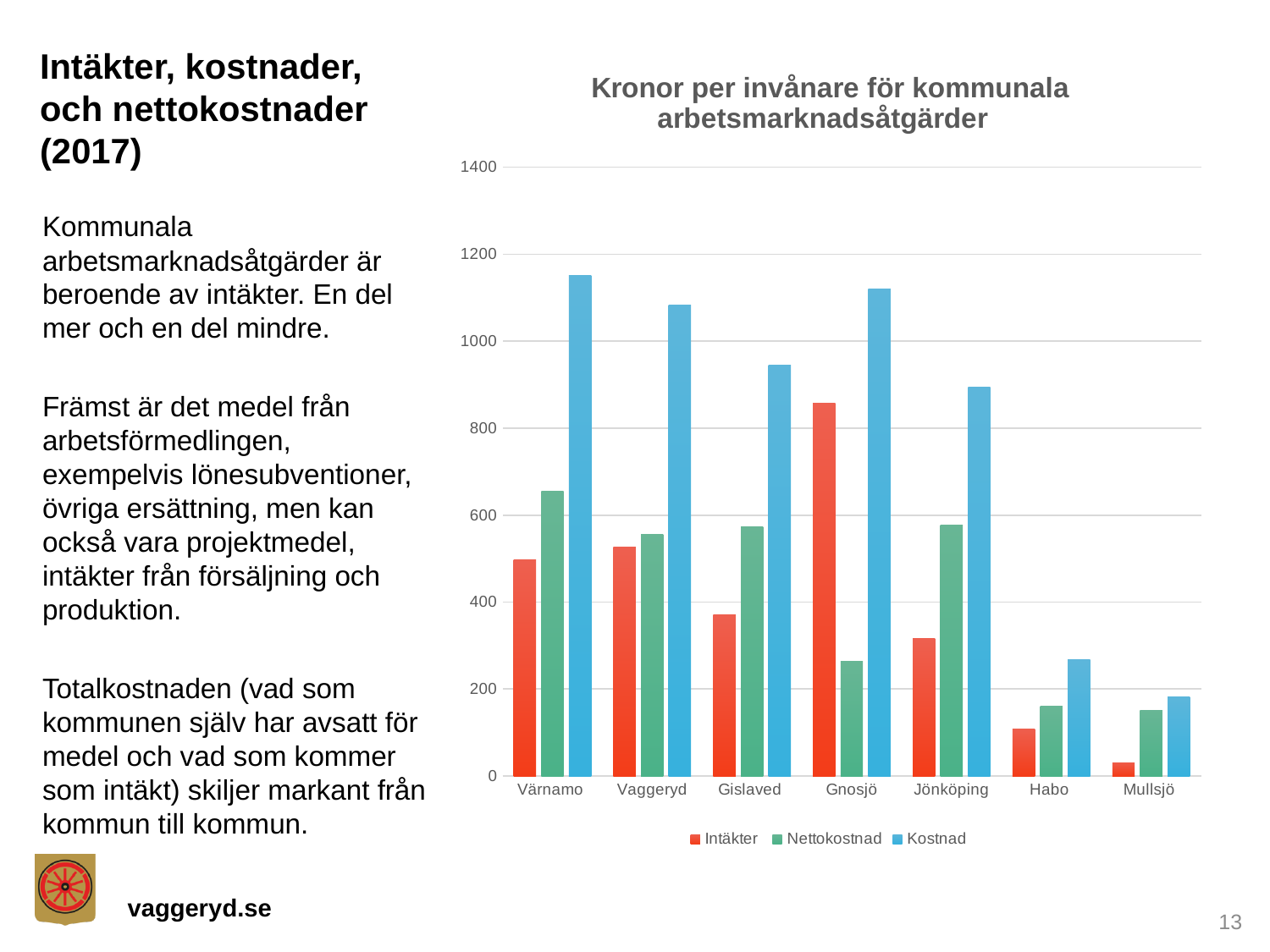
Is the Kostnad value for Gislaved greater or less than 1000? less Which municipality has the lowest Intäkter value? Mullsjö What is the title of the chart? Kronor per invånare för kommunala arbetsmarknadsåtgärder Which municipality has the lowest Kostnad value? Mullsjö How many municipalities are shown on the x axis of the chart? 7 Is the Intäkter value for Gnosjö greater or less than 800? greater How many series does the chart's legend list? 3 What kind of chart is shown on the slide? bar chart For Gnosjö, which is larger: Intäkter or Nettokostnad? Intäkter Which municipality has the highest Nettokostnad value? Värnamo Which municipality has the highest Intäkter value? Gnosjö Is the Kostnad value for Habo greater or less than 200? greater